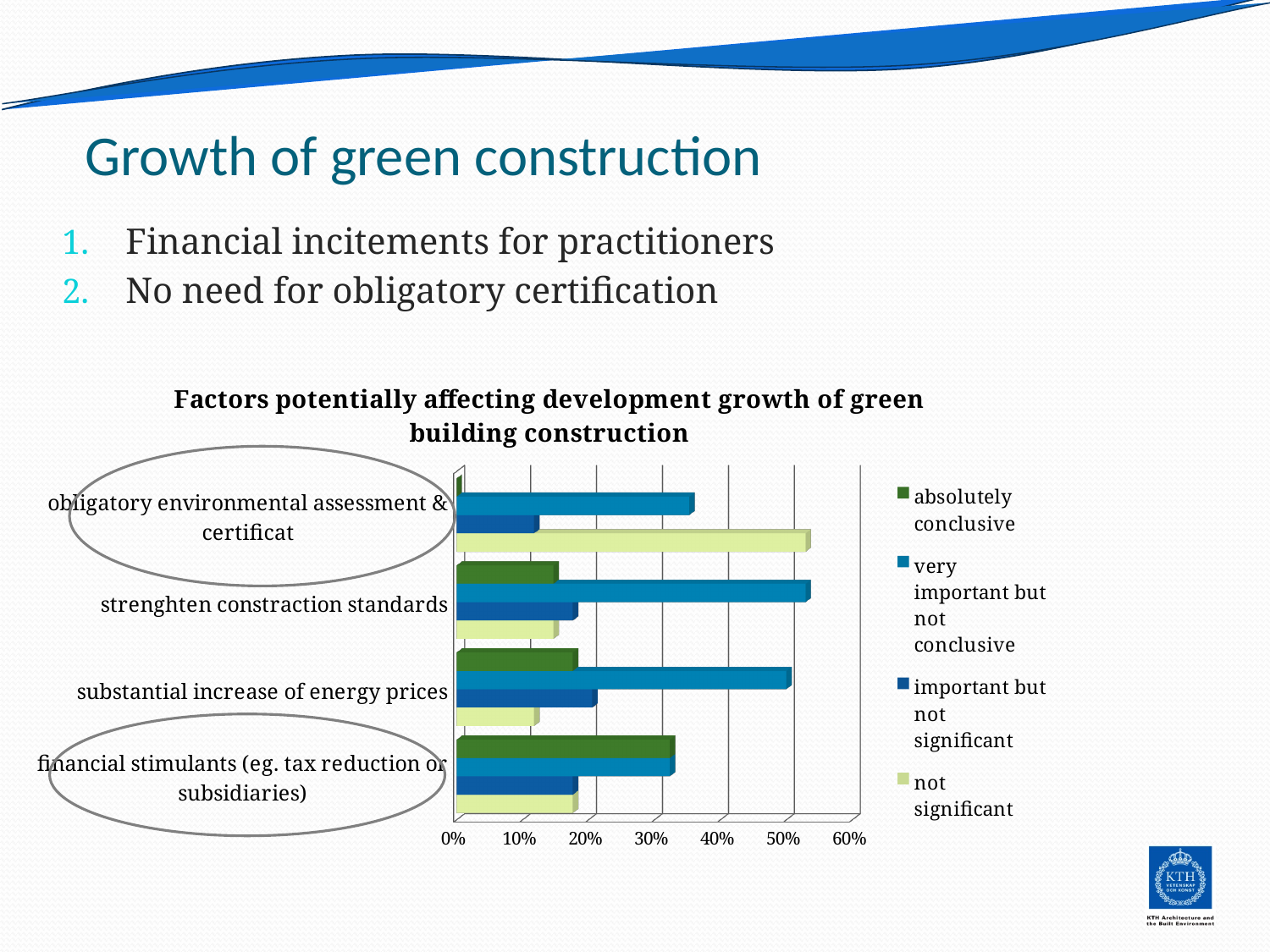
What is the title of the chart? Factors potentially affecting development growth of green building construction How many series does the chart's legend list? 4 How many factors (categories) are plotted in the chart? 4 Which factor has the highest value for the 'absolutely conclusive' series? financial stimulants (eg. tax reduction or subsidiaries) Is the 'very important but not conclusive' value for 'strenghten constraction standards' greater or less than 40%? greater Which factor has the lowest value for the 'absolutely conclusive' series? obligatory environmental assessment & certificat Is the 'absolutely conclusive' value for 'obligatory environmental assessment & certificat' greater or less than 10%? less Is the 'not significant' value for 'obligatory environmental assessment & certificat' greater or less than 40%? greater What kind of chart is shown on the slide? bar chart For 'substantial increase of energy prices', which is larger: the 'very important but not conclusive' value or the 'not significant' value? very important but not conclusive Which factor has the highest value for the 'not significant' series? obligatory environmental assessment & certificat Which factor has the larger 'very important but not conclusive' value: 'strenghten constraction standards' or 'financial stimulants (eg. tax reduction or subsidiaries)'? strenghten constraction standards